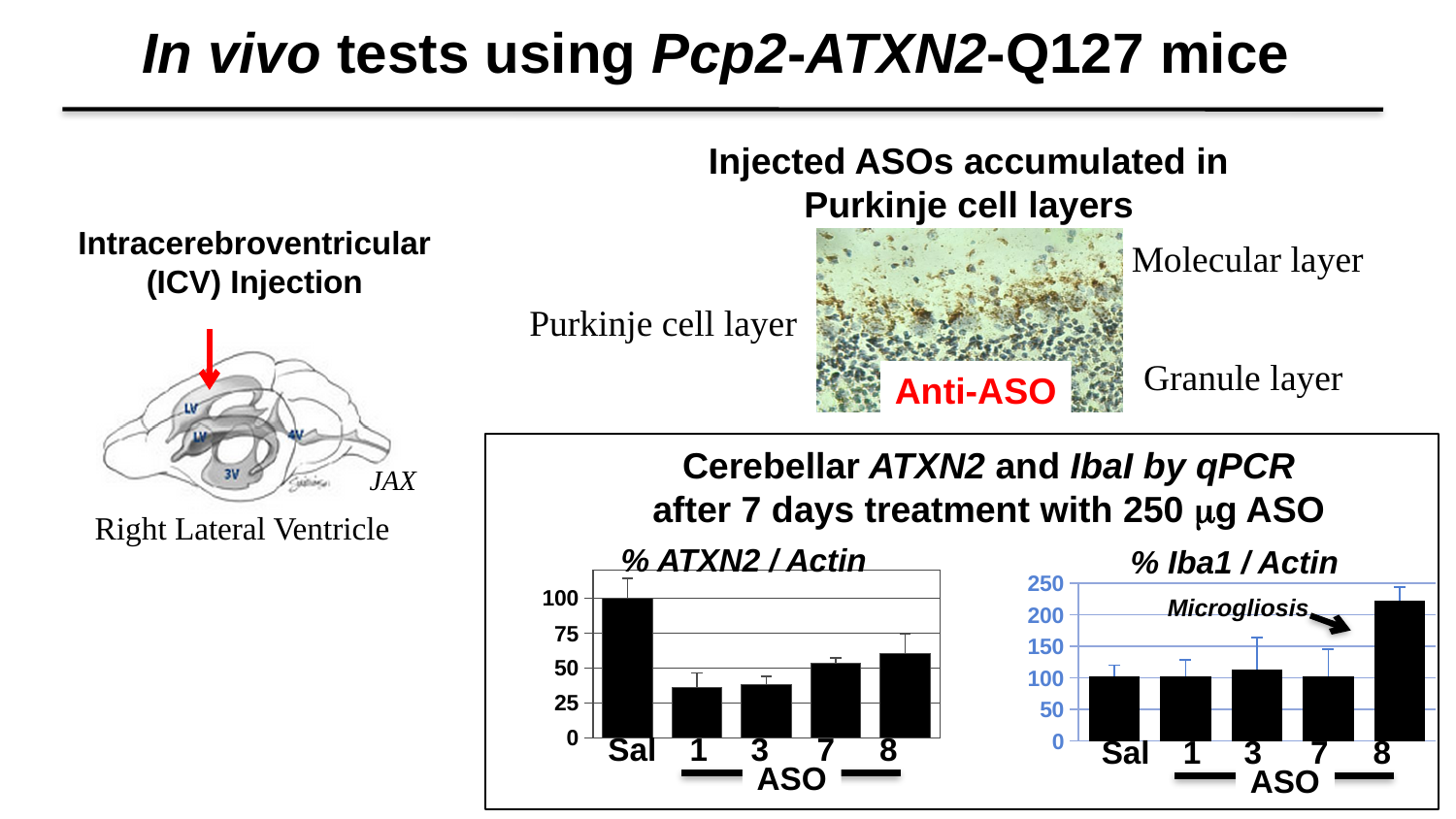
In the "% ATXN2 / Actin" chart, which category has the highest value? Sal In the "% ATXN2 / Actin" chart, what is the value for Sal? 100 In the "% ATXN2 / Actin" chart, is the value for ASO 8 greater or less than 50? greater In the "% Iba1 / Actin" chart, which category has the highest value? 8 In the "% Iba1 / Actin" chart, which bar does the "Microgliosis" arrow point to? 8 In the "% ATXN2 / Actin" chart, do the values rise or fall going from ASO 1 to ASO 8 along the x axis? rise What kind of chart is the "% ATXN2 / Actin" chart? bar chart How many categories are shown on the x axis of the "% Iba1 / Actin" chart? 5 In the "% Iba1 / Actin" chart, is the value for ASO 8 greater or less than 200? greater In the "% ATXN2 / Actin" chart, which is larger, the value for Sal or the value for ASO 8? Sal In the "% ATXN2 / Actin" chart, is the value for ASO 1 greater or less than 50? less In the "% Iba1 / Actin" chart, which is larger, the value for ASO 8 or the value for Sal? 8